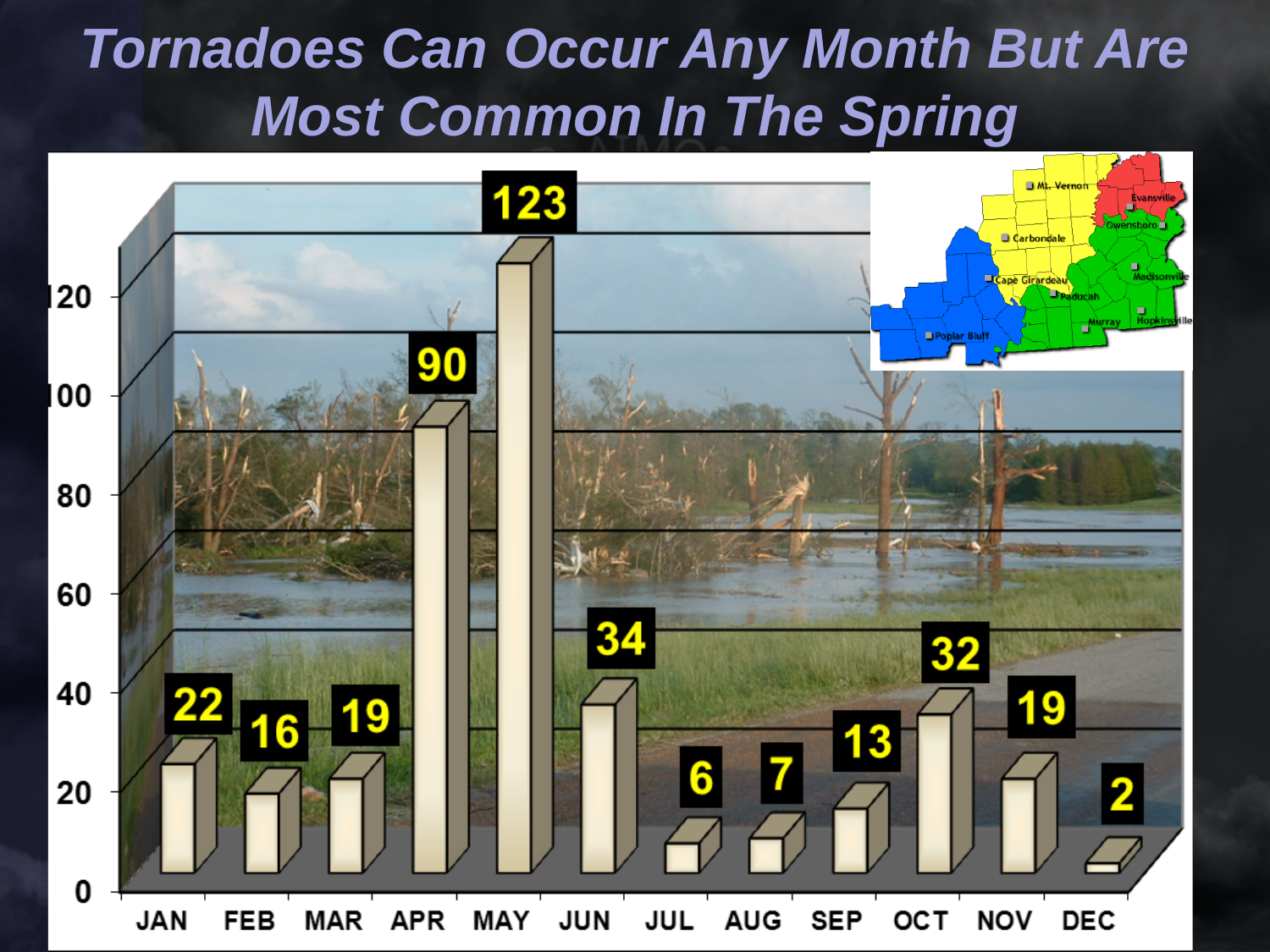
What is the value for DEC? 2 Do the values rise or fall from JUL to OCT? rise What is the value for OCT? 32 What is the difference between the values for MAY and APR? 33 Which month has the highest value? MAY Which is larger, the value for JAN or the value for FEB? JAN What is the value for MAY? 123 What is the difference between the values for JUN and JUL? 28 What is the value for APR? 90 What kind of chart is shown on the slide? bar chart Which month has the lowest value? DEC How many months are shown on the x axis? 12